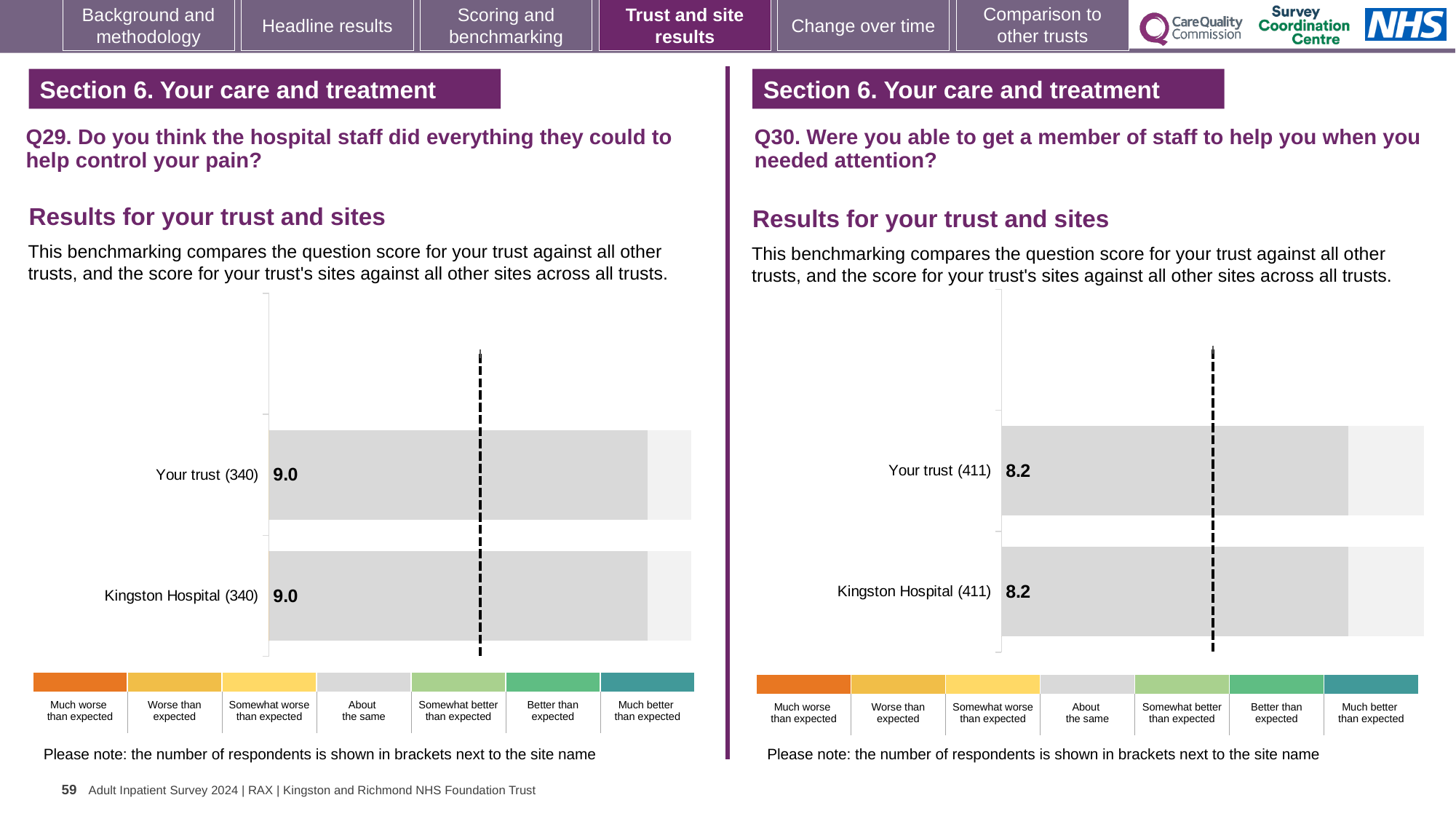
How many benchmark categories are listed in the colour key below the Q30 chart on the right? 7 In the Q30 chart on the right, what is the score for Kingston Hospital? 8.2 In the Q29 chart on the left, how many respondents are shown in brackets for Your trust? 340 In the Q30 chart on the right, how many respondents are shown in brackets for Kingston Hospital? 411 In the Q29 chart on the left, what is the score for Kingston Hospital? 9.0 What is the difference between the Your trust score in the Q29 chart (left) and the Your trust score in the Q30 chart (right)? 0.8 What kind of chart is used for the Q30 results on the right? Bar chart In the Q29 chart on the left, what is the score for Your trust? 9.0 In the Q30 chart on the right, what is the score for Your trust? 8.2 How many bars are plotted in the Q29 chart on the left? 2 In the Q29 chart on the left, what is the difference between the scores for Your trust and Kingston Hospital? 0.0 In the colour key below the Q29 chart on the left, what colour represents 'Much worse than expected'? Orange